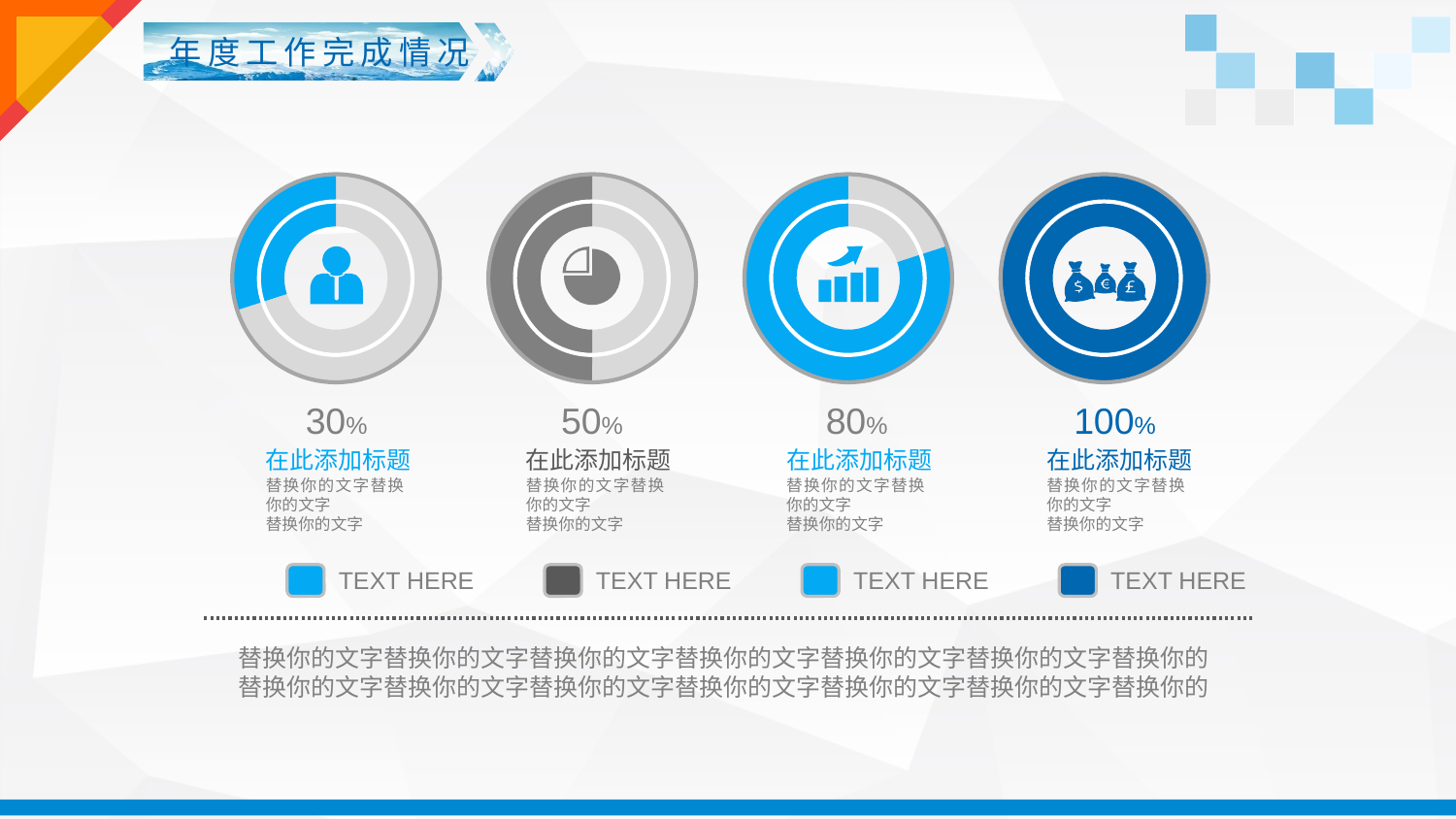
What percentage is shown below the second ring chart from the left? 50% Which ring chart shows the lowest percentage? The first (leftmost) chart, 30% What percentage is shown below the first (leftmost) ring chart? 30% What is the difference between the percentage of the fourth ring chart and the second ring chart? 50% What percentage is shown below the fourth (rightmost) ring chart? 100% Which ring chart shows the highest percentage? The fourth (rightmost) chart, 100% Which is larger, the percentage of the second ring chart or the third ring chart? The third ring chart (80%) What is the difference between the percentage of the third ring chart and the first ring chart? 50% What percentage is shown below the third ring chart from the left? 80% What kind of chart is used to display the percentages on the slide? Ring (donut) chart How many ring charts are shown on the slide? 4 What colour is the filled portion of the second ring chart from the left? Grey